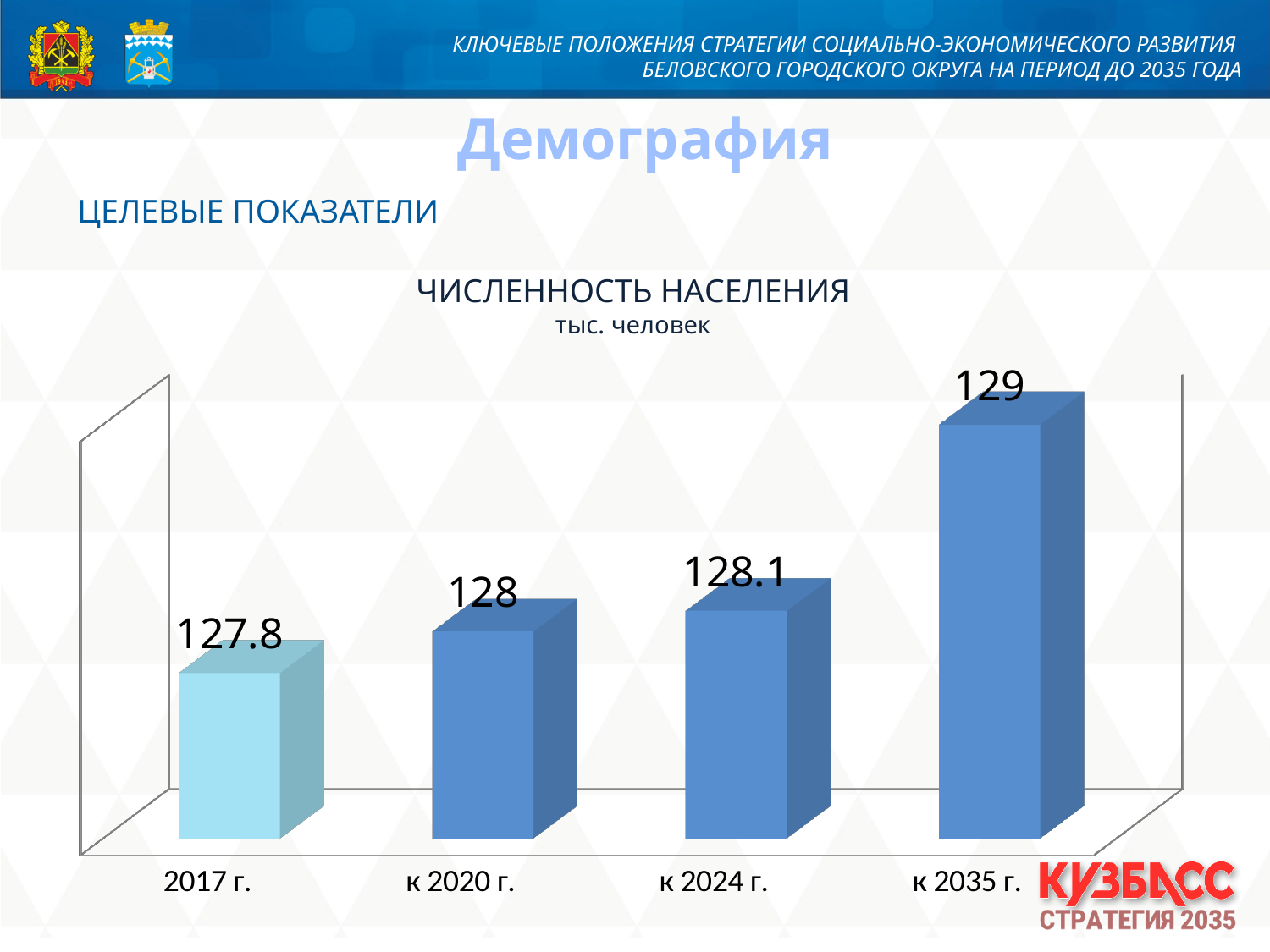
What is the difference between the values for к 2035 г. and 2017 г.? 1.2 What is the population value shown for к 2035 г.? 129 Which category has the highest population value? к 2035 г. What kind of chart is shown on the slide? bar chart What is the population value shown for к 2020 г.? 128 What is the difference between the values for к 2024 г. and к 2020 г.? 0.1 What is the population value shown for к 2024 г.? 128.1 Which category has the lowest population value? 2017 г. How many categories are shown on the chart? 4 Which is larger, the value for к 2035 г. or the value for к 2024 г.? к 2035 г. Do the values rise or fall from 2017 г. to к 2035 г.? rise What is the population value shown for 2017 г.? 127.8